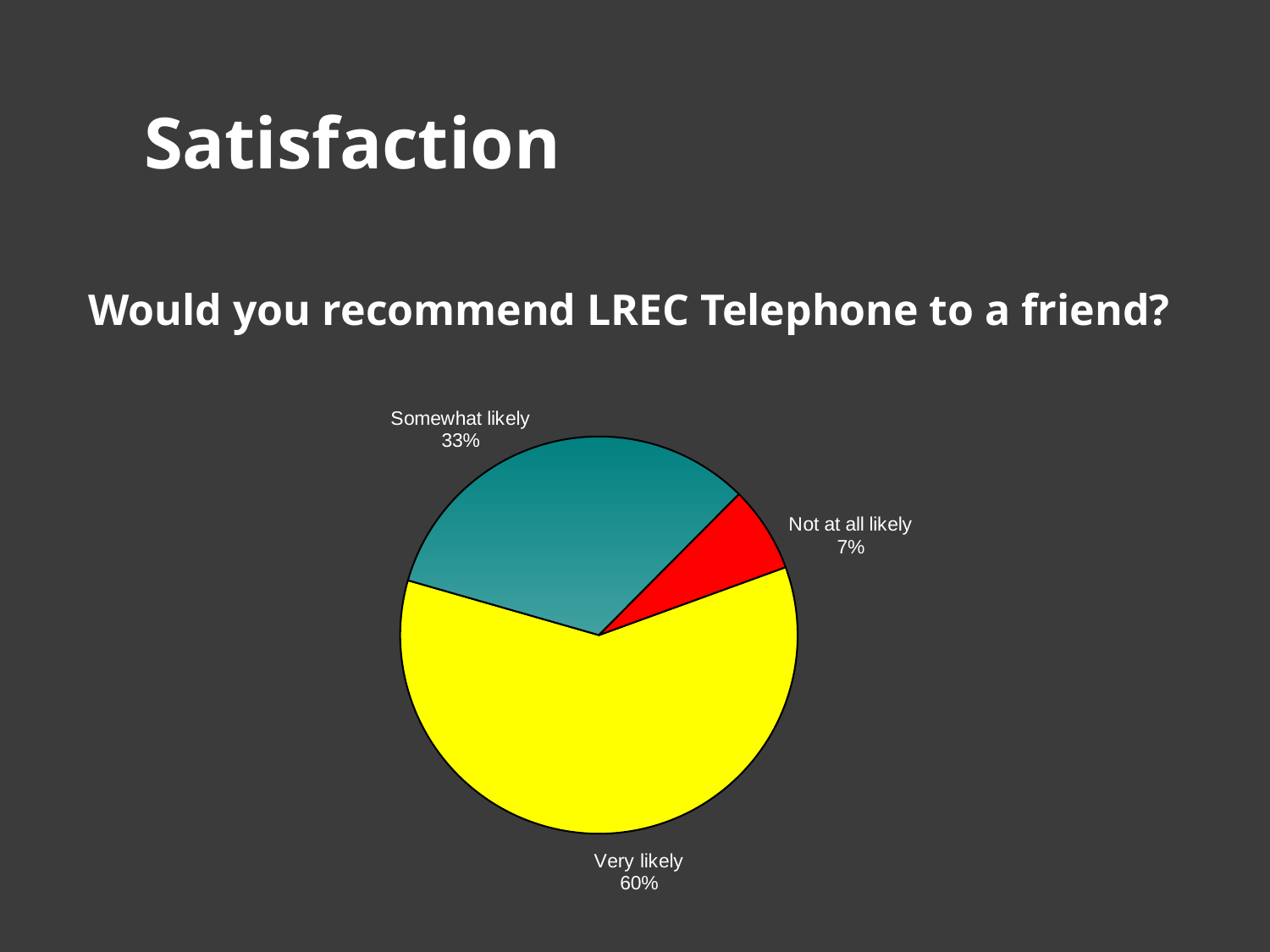
What percentage of respondents said they are very likely to recommend LREC Telephone to a friend? 60% What percentage of respondents said they are somewhat likely to recommend LREC Telephone? 33% What colour is the 'Very likely' slice? Yellow What question does the chart on the slide answer? Would you recommend LREC Telephone to a friend? Which slice is larger: 'Somewhat likely' or 'Not at all likely'? Somewhat likely Which response category has the largest share of the pie? Very likely How many response categories are shown in the pie chart? 3 What is the difference in percentage points between the 'Somewhat likely' and 'Not at all likely' slices? 26 What percentage of respondents said they are not at all likely to recommend LREC Telephone? 7% Which response category has the smallest share of the pie? Not at all likely What type of chart is shown on the slide? Pie chart What is the difference in percentage points between the 'Very likely' and 'Somewhat likely' slices? 27